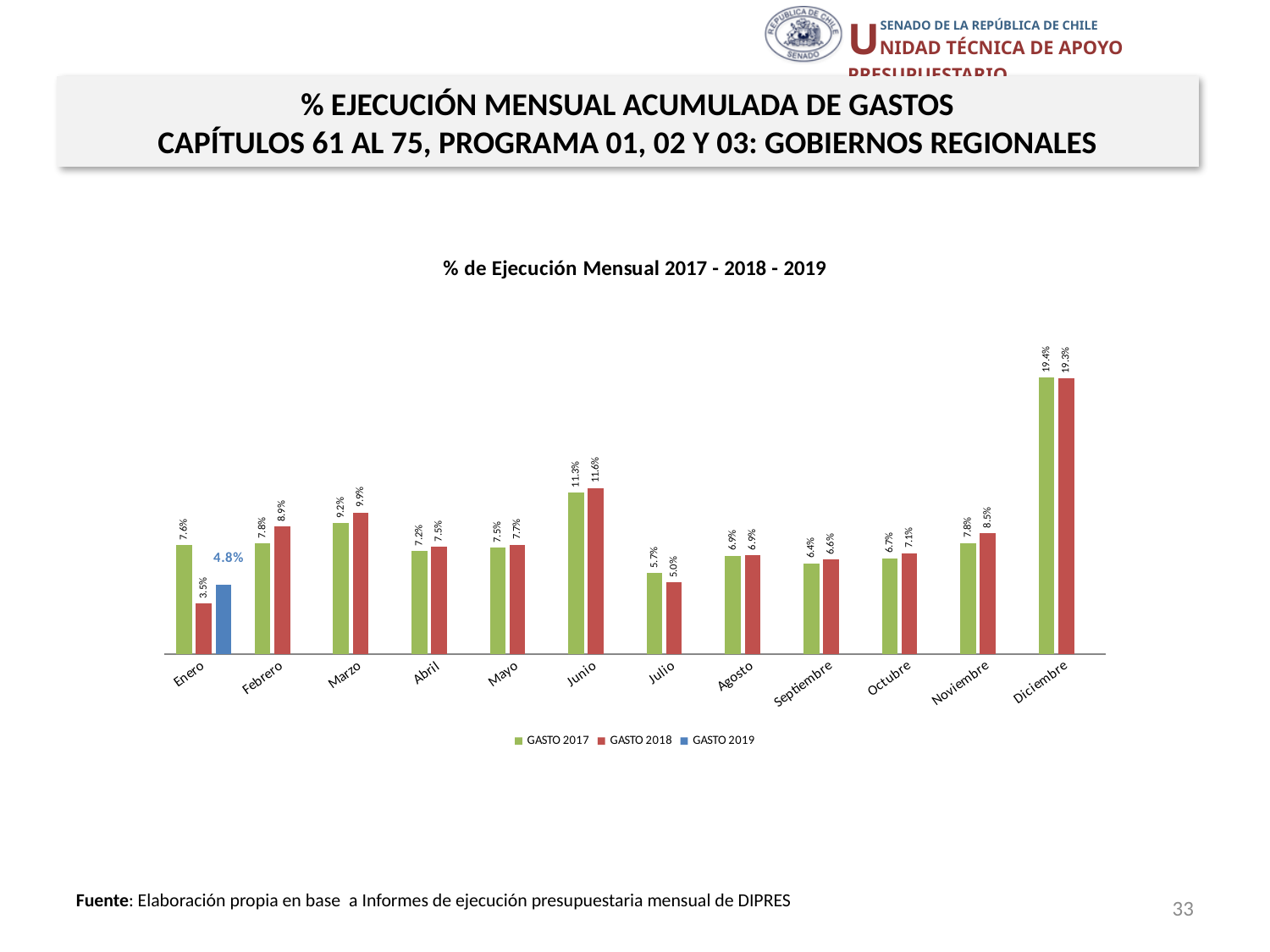
In which month is the GASTO 2018 value lowest? Enero How many series does the legend list? 3 In which month is the GASTO 2018 value highest? Diciembre How many months are shown on the x axis? 12 What is the GASTO 2019 value for Enero? 4.8% Which is larger for Julio, GASTO 2017 or GASTO 2018? GASTO 2017 In which month is the GASTO 2017 value lowest? Julio What kind of chart is shown on the slide? Bar chart What is the GASTO 2018 value for Noviembre? 8.5% What is the GASTO 2017 value for Junio? 11.3% What is the difference between the GASTO 2017 and GASTO 2018 values for Enero? 4.1 percentage points What is the title of the chart? % de Ejecución Mensual 2017 - 2018 - 2019